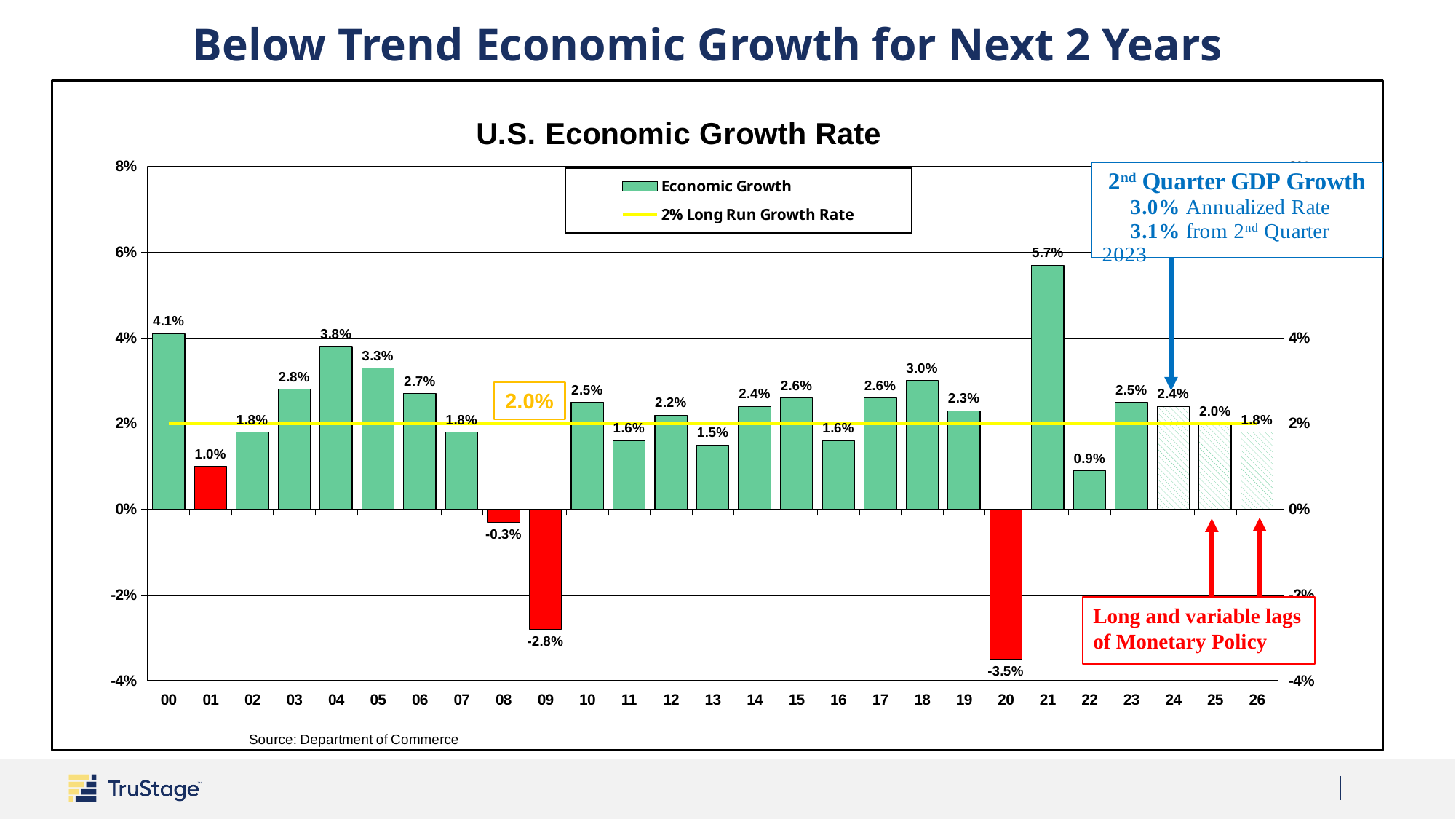
What is the economic growth rate shown for 2004? 3.8% Which year had a higher economic growth rate, 2000 or 2018? 2000 Do the economic growth rates rise or fall from 2023 to 2026? Fall Which year has the lowest economic growth rate on the chart? 20 What type of chart is used to show the U.S. Economic Growth Rate? Combination bar and line chart (bars for economic growth, a line for the 2% long run growth rate) How many years are plotted on the x axis of the chart? 27 What is the long run growth rate marked by the yellow line on the chart? 2% What is the economic growth rate shown for 2020? -3.5% What is the difference between the growth rate in 2021 and the growth rate in 2022? 4.8 percentage points Which year has the highest economic growth rate on the chart? 21 What is the projected economic growth rate shown for 2026? 1.8% How many entries does the chart legend list? 2